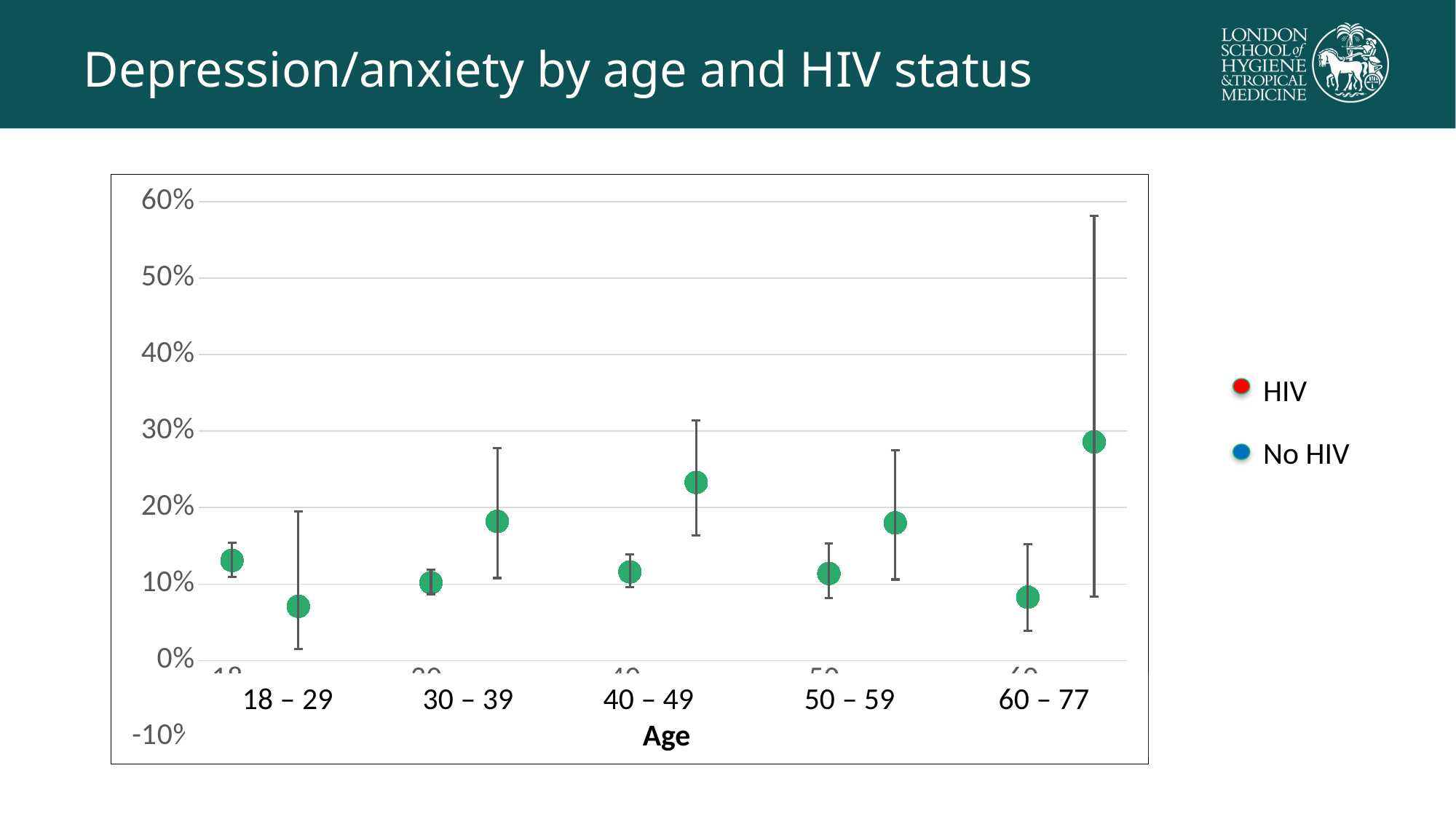
What is the title of the chart? Depression/anxiety by age and HIV status Is the top of the longest error bar in the 60 – 77 age group greater or less than 50%? greater Is the higher of the two points in the 60 – 77 age group greater or less than 20%? greater How many age groups are shown on the x axis? 5 Which age group has the widest error bar? 60 – 77 How many series does the legend list? 2 Which age group contains the highest plotted point? 60 – 77 What kind of chart is this? Scatter (dot) plot with error bars Is the lower of the two points in the 18 – 29 age group greater or less than 10%? less What is the label of the x axis? Age